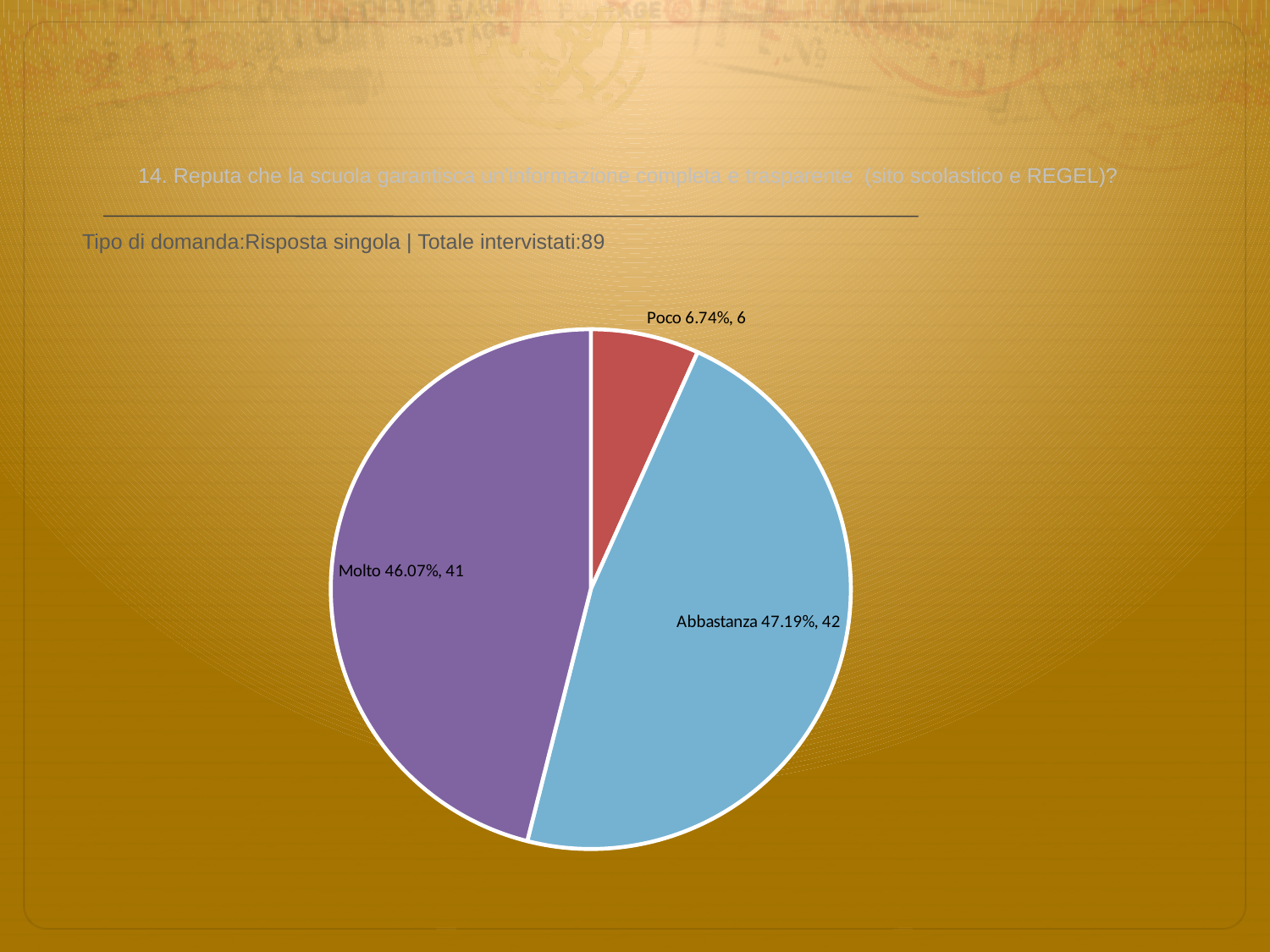
What is the difference in respondent count between Abbastanza and Molto? 1 How many respondents answered Molto? 41 What percentage share does the Molto slice have? 46.07% What kind of chart is shown on the slide? pie chart Which category has the smallest slice? Poco How many slices does the pie chart have? 3 What percentage share does the Poco slice have? 6.74% How many respondents answered Abbastanza? 42 What percentage share does the Abbastanza slice have? 47.19% What is the difference in respondent count between Molto and Poco? 35 What colour is the Poco slice? red How many respondents answered Poco? 6